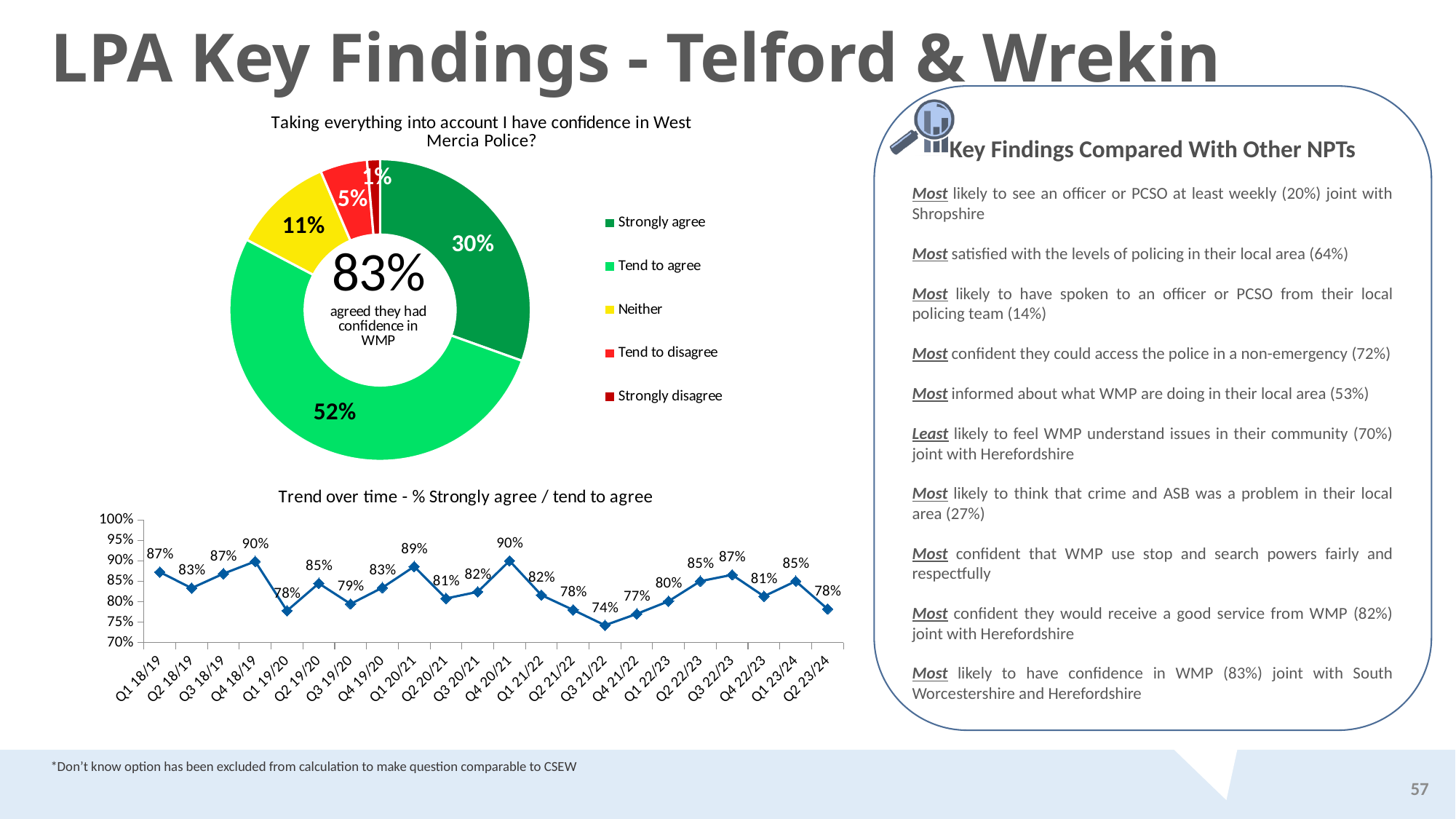
In the chart titled 'Taking everything into account I have confidence in West Mercia Police?', which category has the largest share? Tend to agree How many data points are plotted in the chart titled 'Trend over time - % Strongly agree / tend to agree'? 22 In the chart titled 'Trend over time - % Strongly agree / tend to agree', what is the value for Q2 23/24? 78% In the chart titled 'Trend over time - % Strongly agree / tend to agree', what is the value for Q3 21/22? 74% What type of chart is the chart titled 'Taking everything into account I have confidence in West Mercia Police?'? Pie chart (doughnut) How many categories does the legend of the chart titled 'Taking everything into account I have confidence in West Mercia Police?' list? 5 In the chart titled 'Trend over time - % Strongly agree / tend to agree', which is larger: the value for Q1 20/21 or the value for Q2 20/21? Q1 20/21 In the chart titled 'Taking everything into account I have confidence in West Mercia Police?', what percentage is shown for 'Tend to agree'? 52% In the chart titled 'Taking everything into account I have confidence in West Mercia Police?', which category has the smallest share? Strongly disagree In the chart titled 'Taking everything into account I have confidence in West Mercia Police?', what percentage is shown for 'Neither'? 11% In the chart titled 'Trend over time - % Strongly agree / tend to agree', which quarter has the lowest value? Q3 21/22 In the chart titled 'Taking everything into account I have confidence in West Mercia Police?', what is the difference in percentage points between 'Tend to agree' and 'Strongly agree'? 22